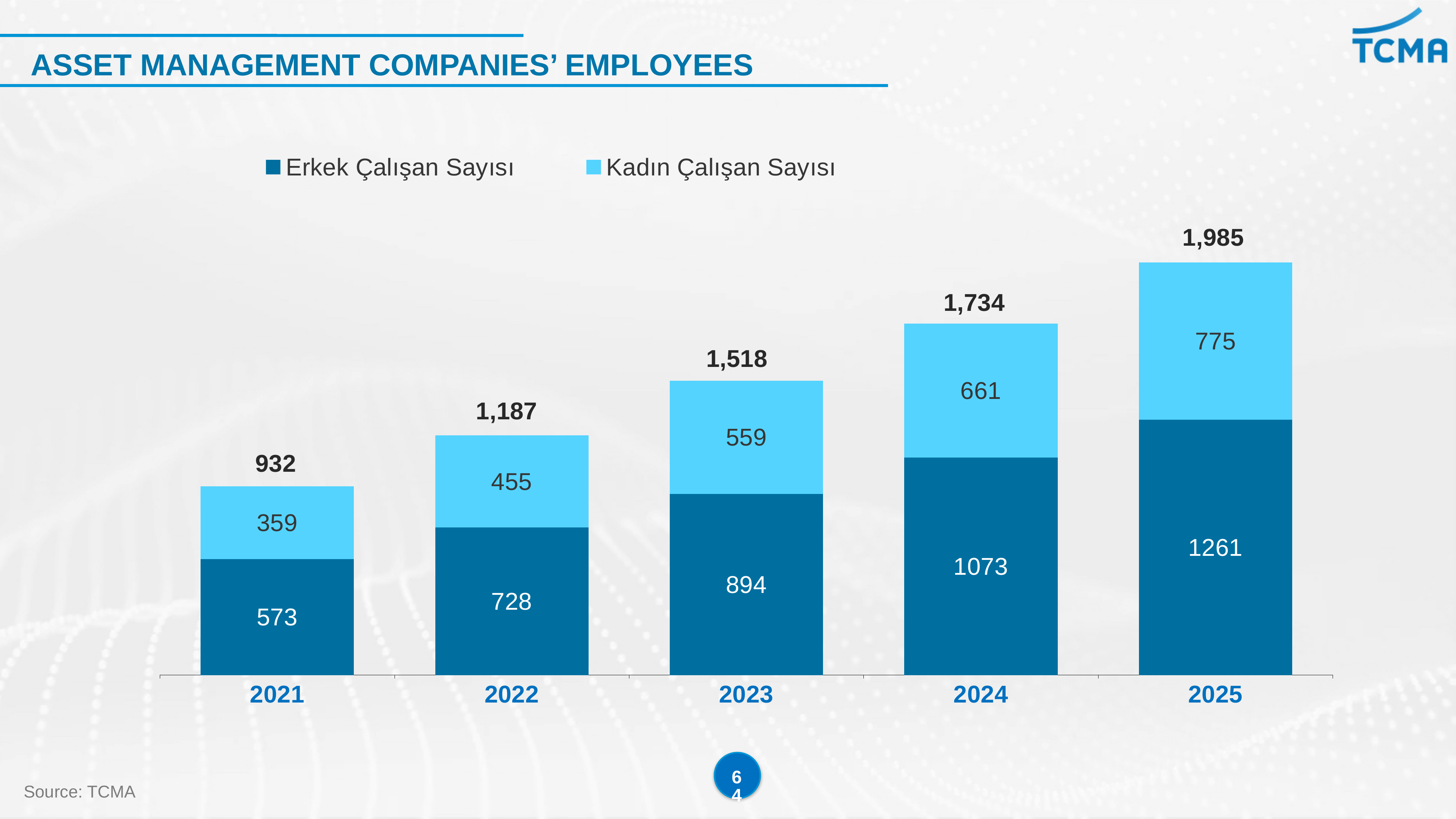
What is the total of the stacked bar for 2024? 1,734 What kind of chart is shown on the slide? Stacked bar chart How many series does the legend list? 2 What is the value of Kadın Çalışan Sayısı for 2022? 455 Which is larger in 2021: Erkek Çalışan Sayısı or Kadın Çalışan Sayısı? Erkek Çalışan Sayısı Which year has the highest total number of employees? 2025 Which year has the lowest value for Kadın Çalışan Sayısı? 2021 How many years are shown on the x axis? 5 Do the total employee numbers rise or fall from 2021 to 2025? Rise What is the value of Erkek Çalışan Sayısı for 2023? 894 What is the title of the chart on the slide? ASSET MANAGEMENT COMPANIES' EMPLOYEES What is the difference between Erkek Çalışan Sayısı and Kadın Çalışan Sayısı in 2025? 486